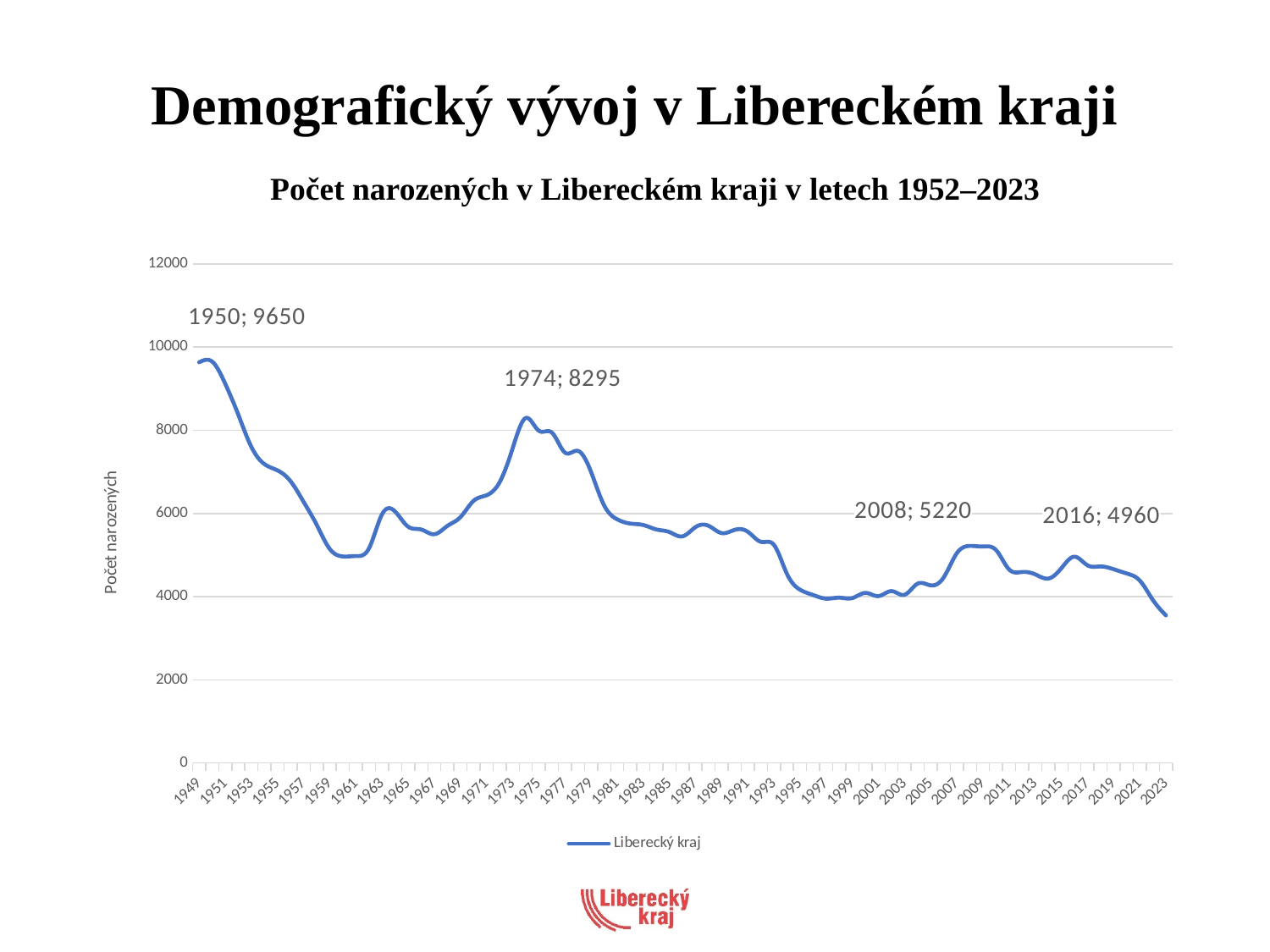
What value is labelled for the year 1974? 8295 What value is labelled for the year 2016? 4960 Which year has the larger labelled value, 1974 or 2008? 1974 What kind of chart is shown on the slide? line chart Is the value for 2023 greater or less than 4000? less What is the difference between the labelled values for 1950 and 1974? 1355 Is the value for 1985 greater or less than 6000? less What value is labelled for the year 2008? 5220 What is the difference between the labelled values for 2008 and 2016? 260 How many series does the legend list? 1 Overall, do the values rise or fall from 1949 to 2023? fall What value is labelled for the year 1950? 9650